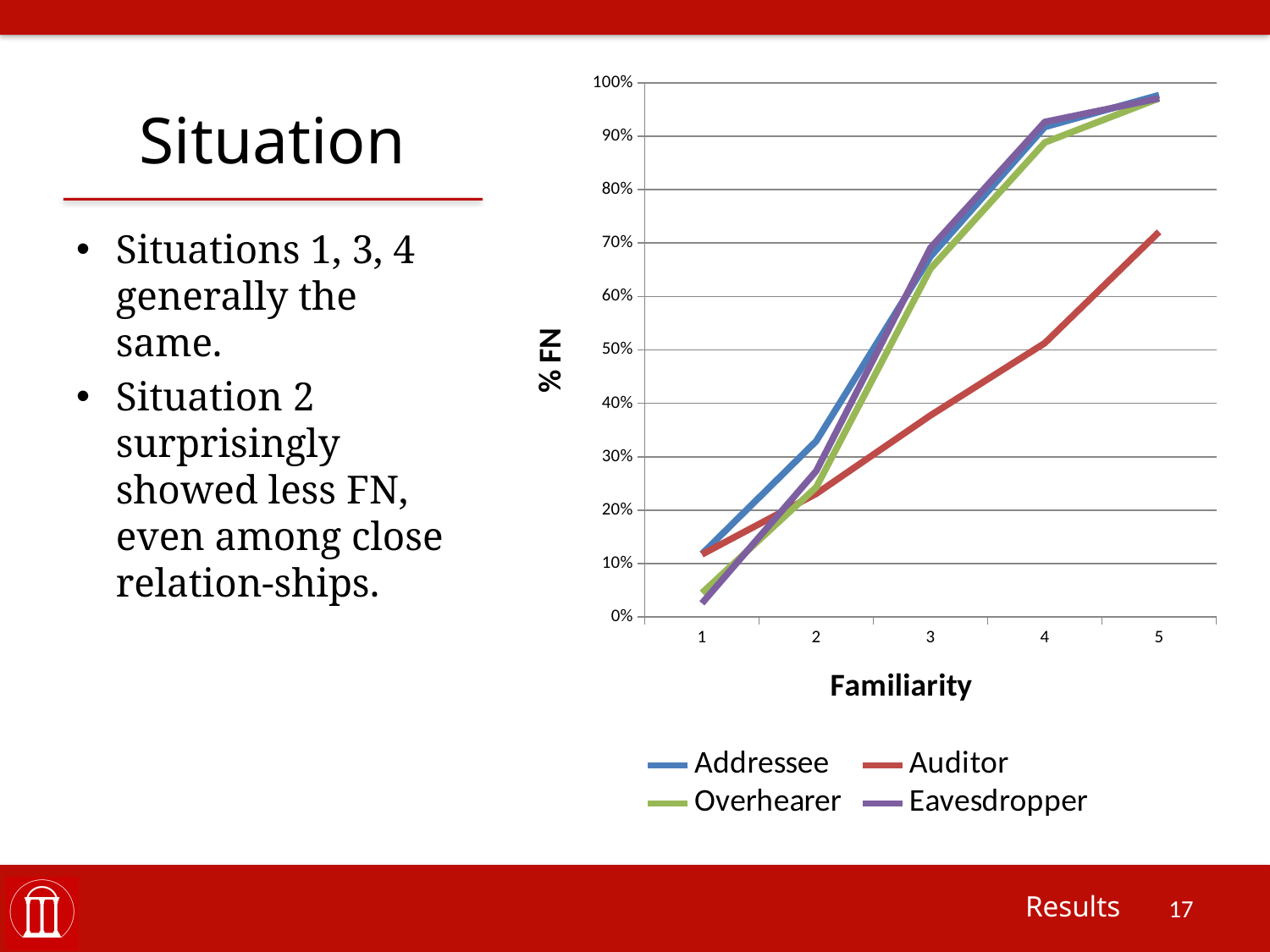
Which series has the lowest value at Familiarity 5? Auditor How many series does the legend list? 4 What is the title of the y axis? % FN Is the value for Auditor at Familiarity 3 greater or less than 50%? less How many Familiarity levels are plotted along the x axis? 5 Is the value for Eavesdropper at Familiarity 1 greater or less than 10%? less At Familiarity 5, which is larger: Addressee or Auditor? Addressee Is the value for Addressee at Familiarity 4 greater or less than 80%? greater What kind of chart is shown on the slide? line chart At Familiarity 4, which is larger: Auditor or Overhearer? Overhearer Does the Auditor line rise or fall as Familiarity increases from 1 to 5? rise